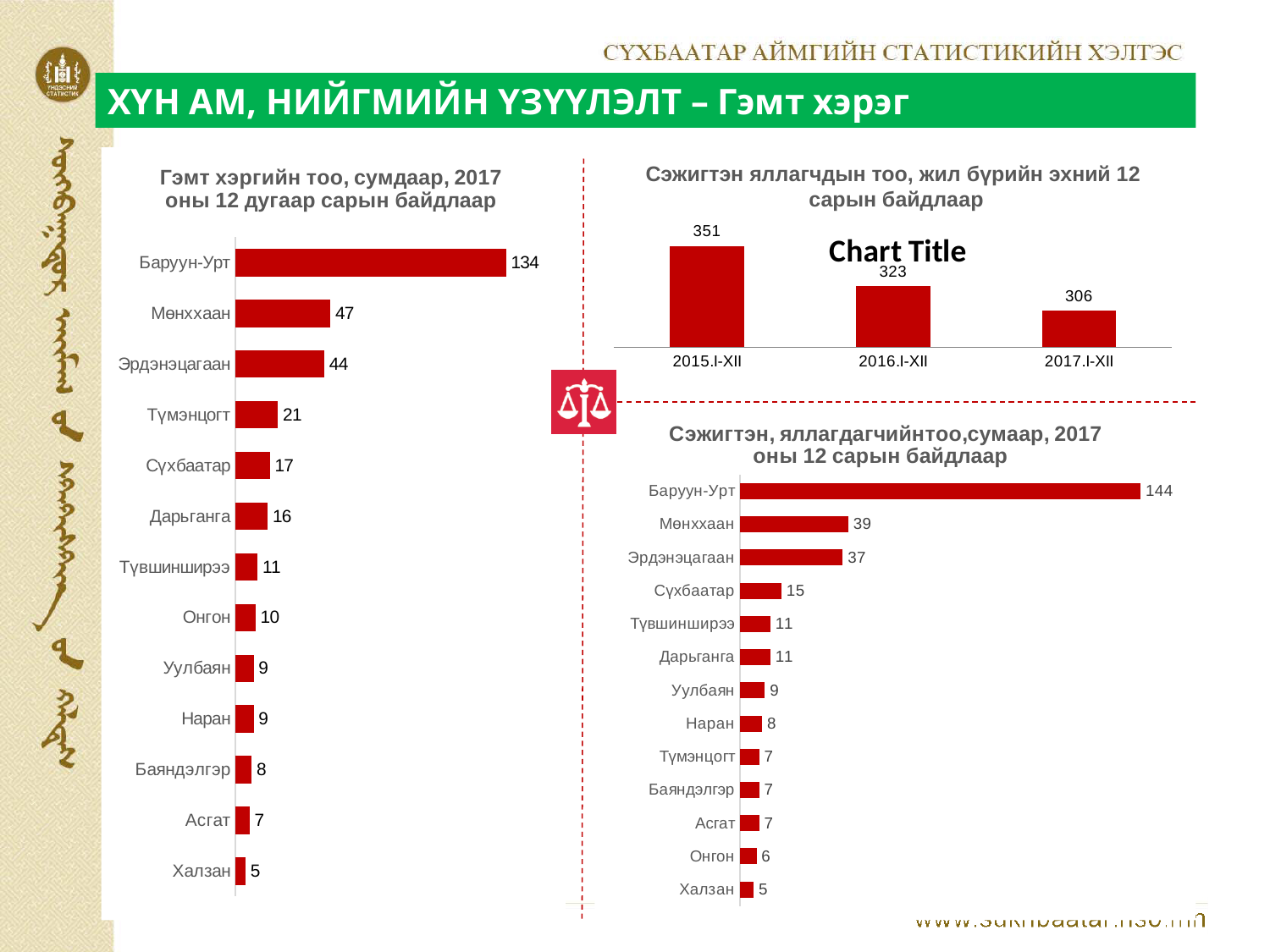
In the left chart (Гэмт хэргийн тоо, сумдаар), what is the value for Баруун-Урт? 134 In the left chart (Гэмт хэргийн тоо, сумдаар), how many categories are shown? 13 In the bottom right chart (Сэжигтэн, яллагдагчийн тоо, сумаар), what is the value for Сүхбаатар? 15 In the bottom right chart (Сэжигтэн, яллагдагчийн тоо, сумаар), what is the value for Баруун-Урт? 144 In the left chart (Гэмт хэргийн тоо, сумдаар), which category has the lowest value? Халзан In the top right chart (Сэжигтэн яллагчдын тоо), what is the value for 2015.I-XII? 351 In the top right chart (Сэжигтэн яллагчдын тоо), what is the difference between 2016.I-XII and 2017.I-XII? 17 In the left chart (Гэмт хэргийн тоо, сумдаар), what is the value for Түмэнцогт? 21 In the left chart (Гэмт хэргийн тоо, сумдаар), what is the difference between Мөнххаан and Эрдэнэцагаан? 3 In the top right chart (Сэжигтэн яллагчдын тоо), what kind of chart is it? bar chart In the top right chart (Сэжигтэн яллагчдын тоо), do the values rise or fall from 2015.I-XII to 2017.I-XII? fall In the bottom right chart (Сэжигтэн, яллагдагчийн тоо, сумаар), which is larger, Мөнххаан or Эрдэнэцагаан? Мөнххаан